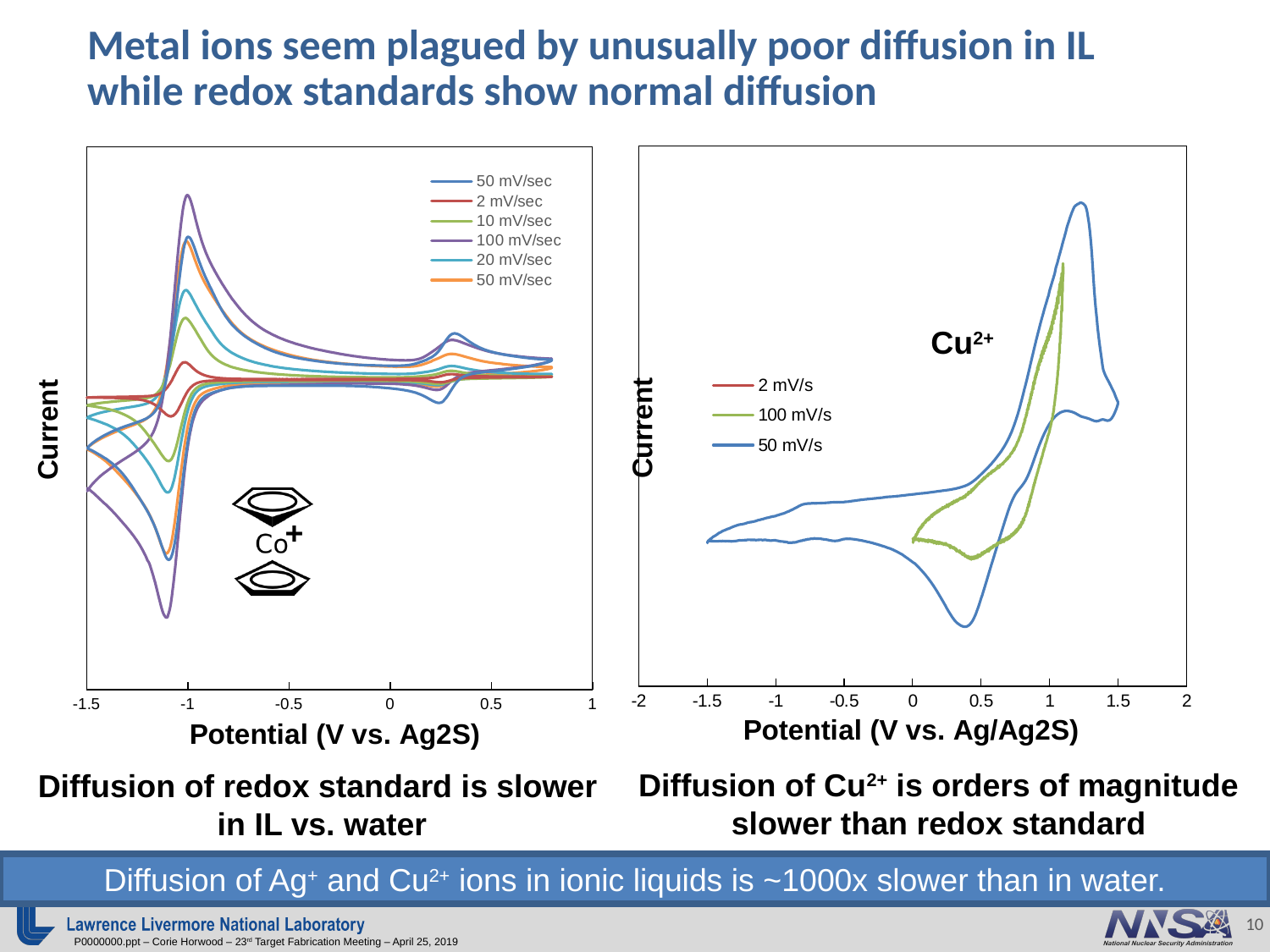
What kind of chart is the left chart? line chart In the right chart (Cu2+), which series reaches a higher peak current, 50 mV/s or 100 mV/s? 50 mV/s What kind of chart is the right chart (Cu2+)? line chart What is the x-axis title of the right chart (Cu2+)? Potential (V vs. Ag/Ag2S) In the left chart, which series reaches the highest peak current? 100 mV/sec What is the y-axis title of the left chart? Current How many series does the legend of the left chart list? 6 In the right chart (Cu2+), is the potential at which the 50 mV/s curve reaches its maximum current greater or less than 1? greater How many series does the legend of the right chart (Cu2+) list? 3 In the right chart (Cu2+), which series is drawn in blue? 50 mV/s In the left chart, is the potential at which the 100 mV/sec curve reaches its minimum current greater or less than -0.5? less